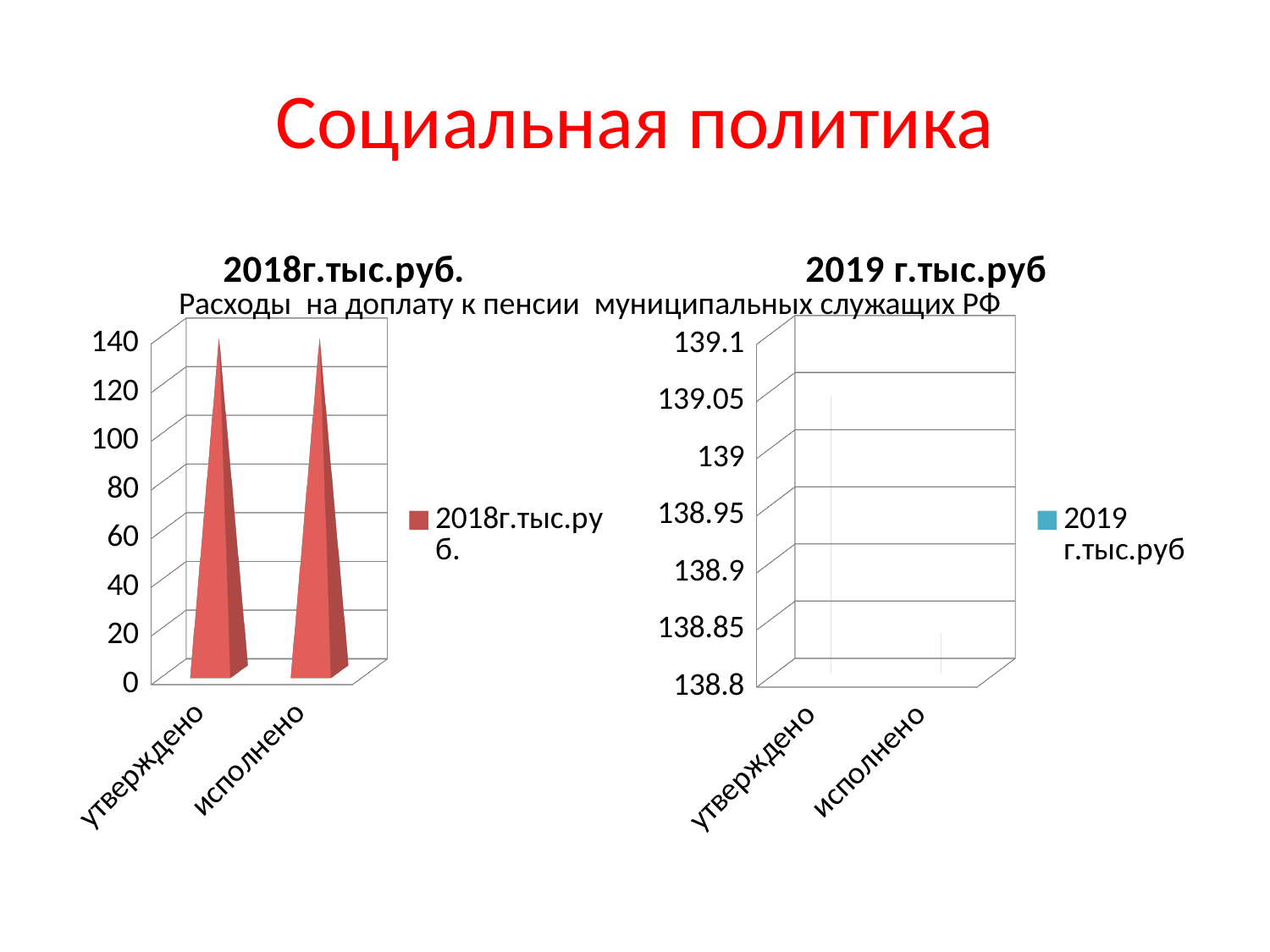
What kind of chart is the right chart titled "2019 г.тыс.руб"? bar chart How many series does the legend of the left chart (2018г.тыс.руб.) list? 1 In the left chart (2018г.тыс.руб.), how many categories are shown on the x axis? 2 In the right chart (2019 г.тыс.руб), how many categories are shown on the x axis? 2 What is the legend entry of the right chart (2019 г.тыс.руб)? 2019 г.тыс.руб What colour are the bars in the left chart (2018г.тыс.руб.)? red In the left chart (2018г.тыс.руб.), is the value for утверждено greater or less than 100? greater In the left chart (2018г.тыс.руб.), is the value for исполнено greater or less than 120? greater What kind of chart is the left chart titled "2018г.тыс.руб."? bar chart How many series does the legend of the right chart (2019 г.тыс.руб) list? 1 What are the two category labels on the x axis of the left chart (2018г.тыс.руб.)? утверждено, исполнено